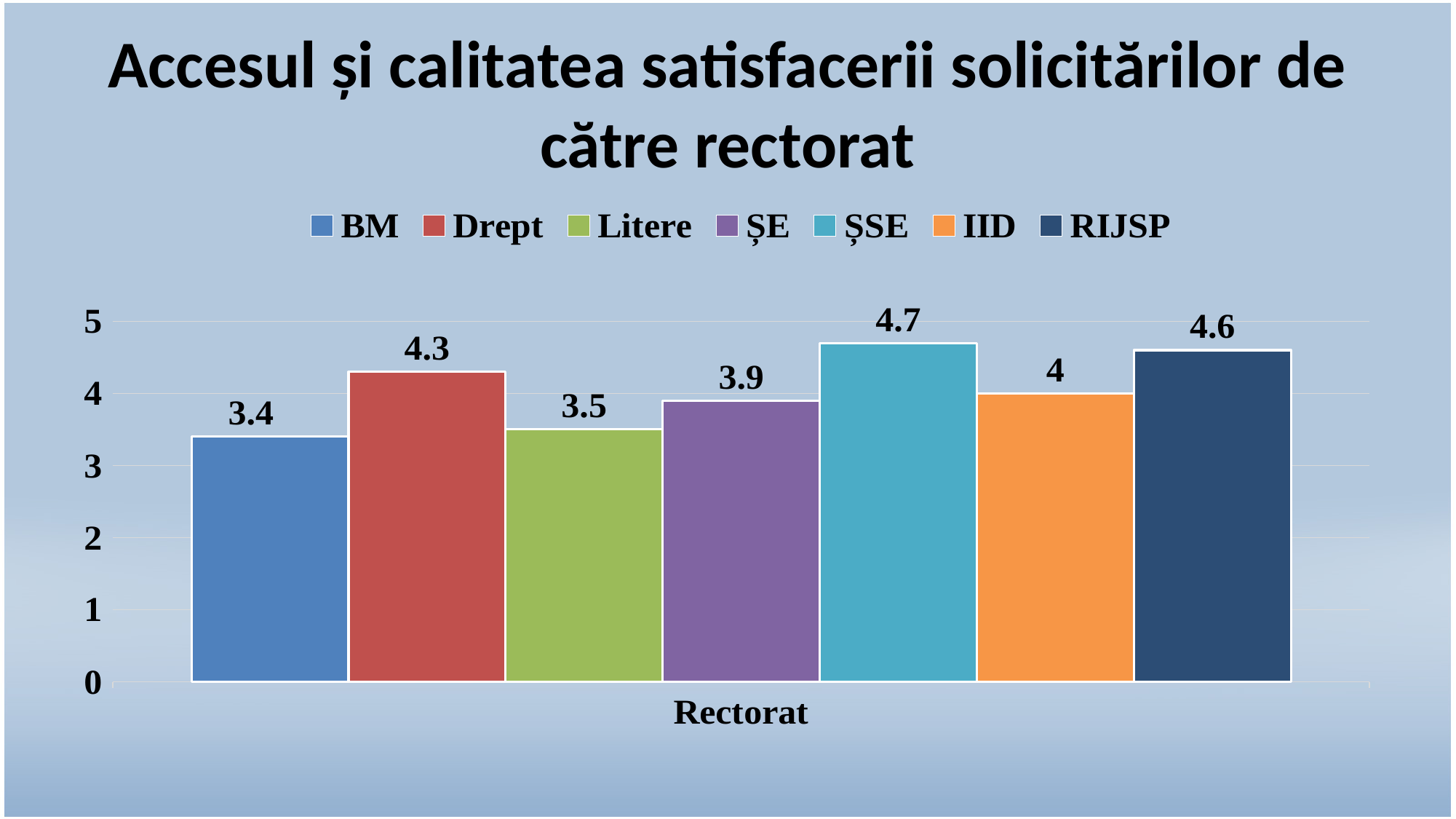
What is the label on the x axis of the chart? Rectorat How many bars are plotted in the chart? 7 How many series does the legend list? 7 What is the value for ȘSE? 4.7 What kind of chart is shown on the slide? bar chart What is the difference between the values for Drept and Litere? 0.8 What is the value for IID? 4 Which series has the highest value? ȘSE Is the value for Drept greater or less than 4? greater What is the value for BM? 3.4 Which series has the lowest value? BM Which is larger, the value for ȘE or the value for RIJSP? RIJSP